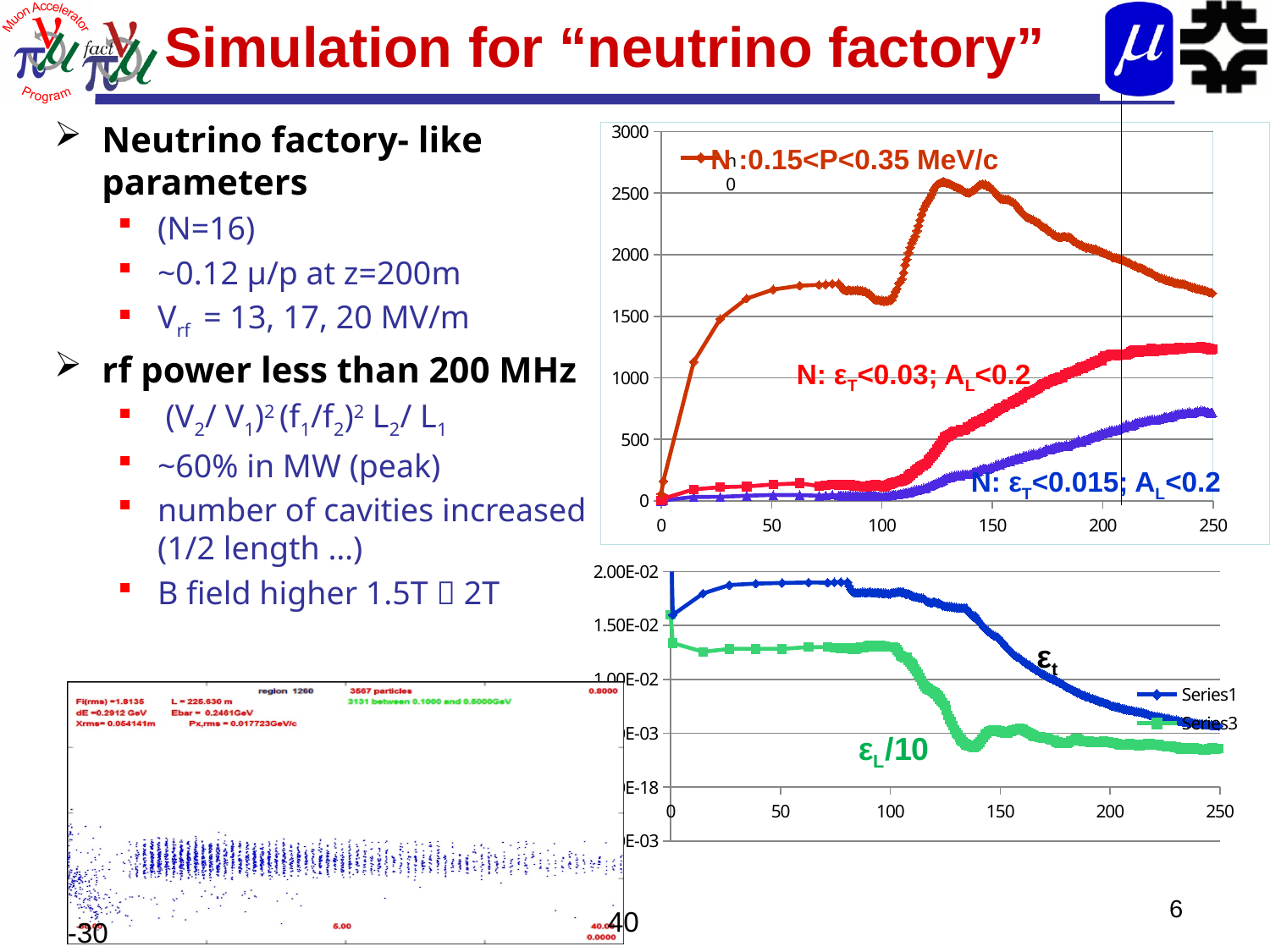
In the top chart, is the value of the N: εT<0.015; AL<0.2 series at x=250 greater or less than 1000? less In the top chart, is the value of the N: 0.15<P<0.35 MeV/c series at x=250 greater or less than 1500? greater In the bottom chart, is the value of Series1 at x=50 greater or less than 1.50E-02? greater How many series does the legend of the bottom chart list? 2 What is the maximum value shown on the vertical axis of the top chart? 3000 In the top chart, at x=250, which is larger: the N: εT<0.03; AL<0.2 series or the N: εT<0.015; AL<0.2 series? N: εT<0.03; AL<0.2 In the top chart, which series reaches the highest value? N: 0.15<P<0.35 MeV/c In the bottom chart, at x=250, which is larger: Series1 or Series3? Series1 In the top chart, does the N: εT<0.03; AL<0.2 series rise or fall between x=100 and x=250? rise In the bottom chart, does Series1 rise or fall between x=100 and x=250? fall What kind of chart is the top chart on the slide? line chart